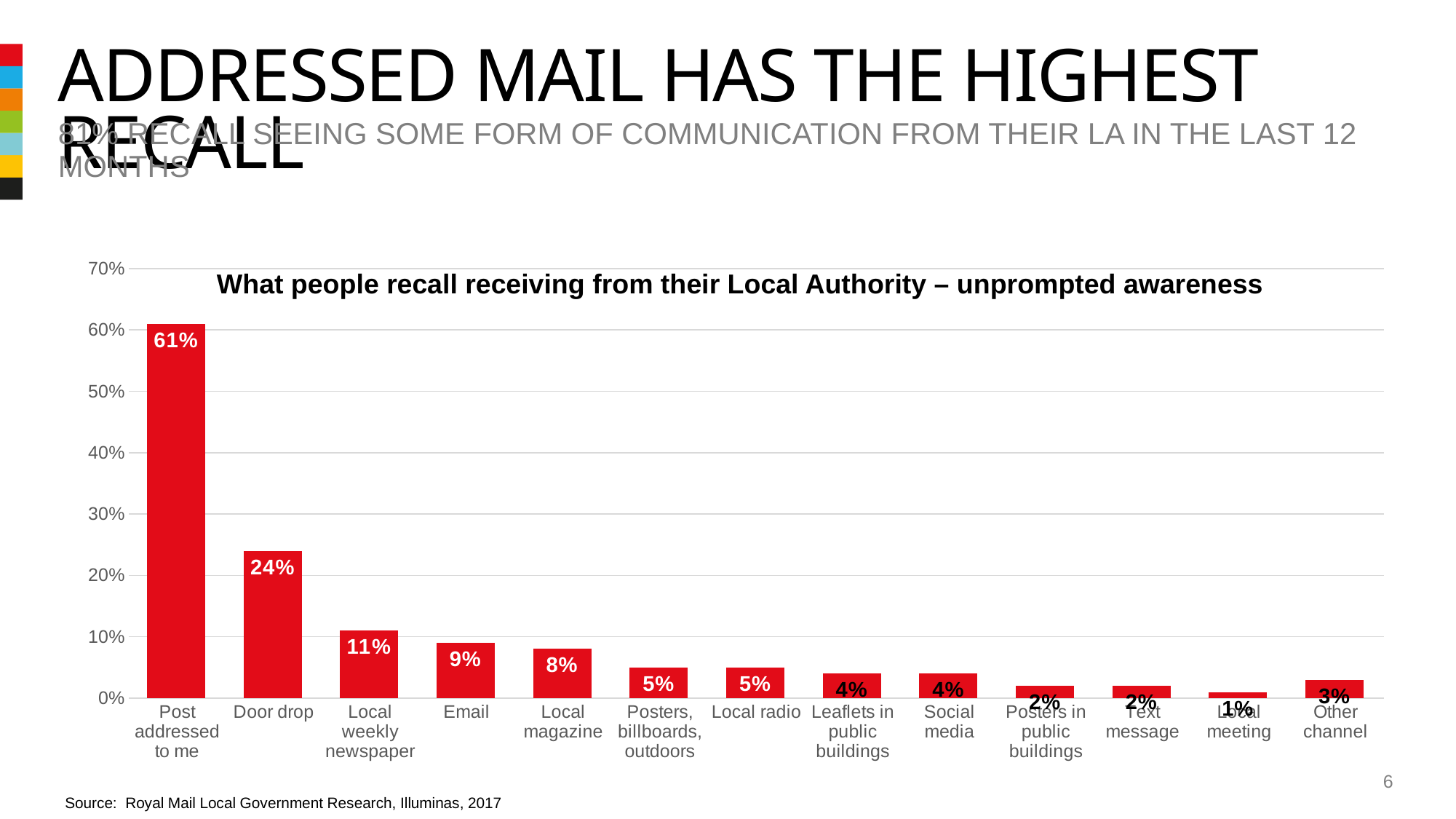
Is the value for Door drop greater or less than 20%? greater What is the difference between the values for Post addressed to me and Door drop? 37% Which category has the highest recall? Post addressed to me What is the title of the chart? What people recall receiving from their Local Authority – unprompted awareness What kind of chart is shown on the slide? Bar chart What percentage of people recall receiving post addressed to them from their Local Authority? 61% What is the value for Door drop? 24% Which is larger, the value for Local weekly newspaper or the value for Local magazine? Local weekly newspaper What is the value for Social media? 4% What is the value for Email? 9% How many categories are shown on the x axis? 13 Which category has the lowest recall? Local meeting